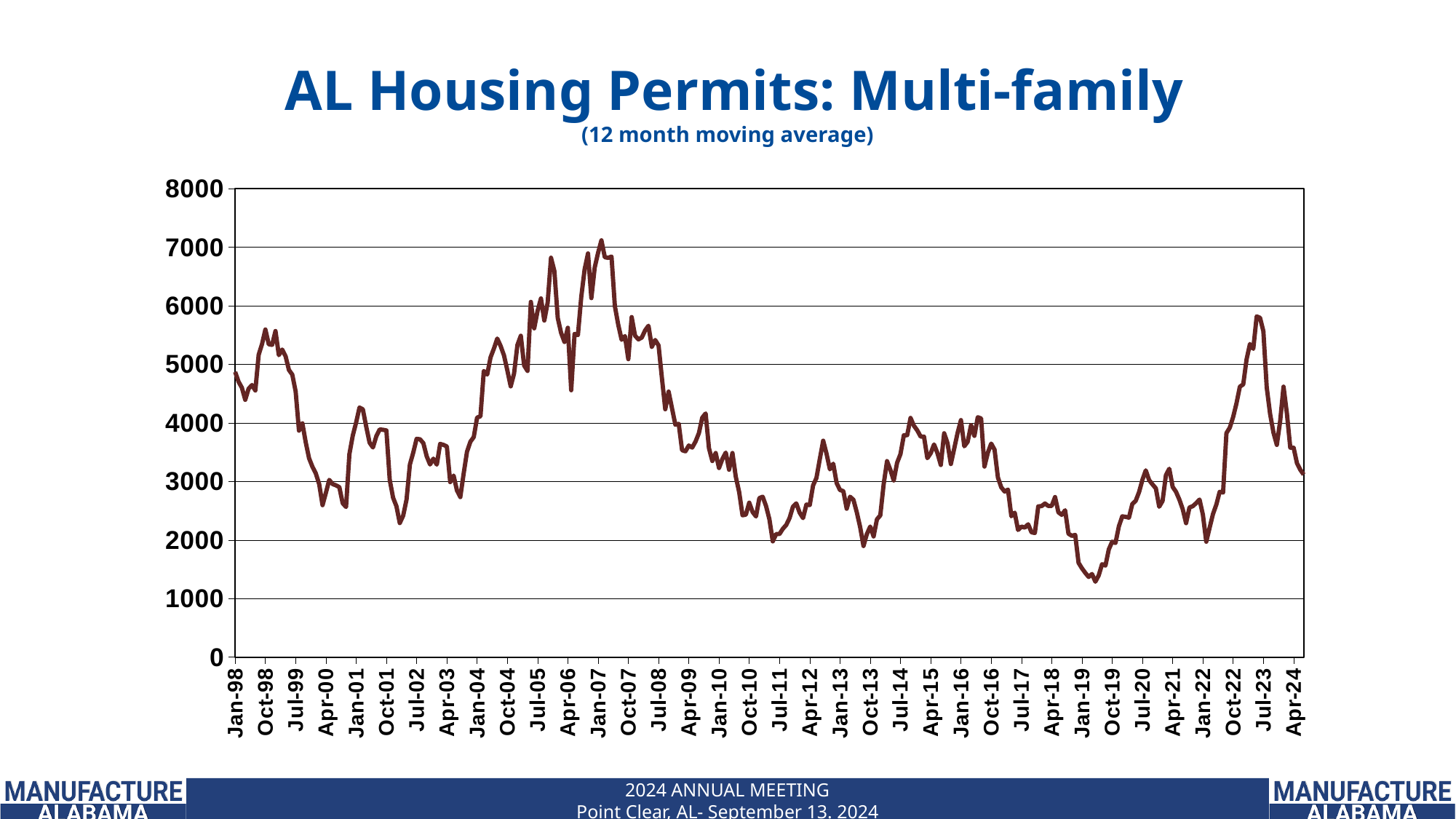
Is the value at Jan-98 greater or less than 4000? greater Is the value at Jul-23 greater or less than 5000? greater What kind of chart is shown on the slide? line chart Is the value at Jan-19 greater or less than 2000? less What averaging period does the subtitle say the chart uses? 12 month moving average Around which x-axis label does the line reach its lowest point? Jan-19 Do the values rise or fall from Jul-23 to Apr-24? fall What is the title of the chart? AL Housing Permits: Multi-family Around which x-axis label does the line reach its highest point? Jan-07